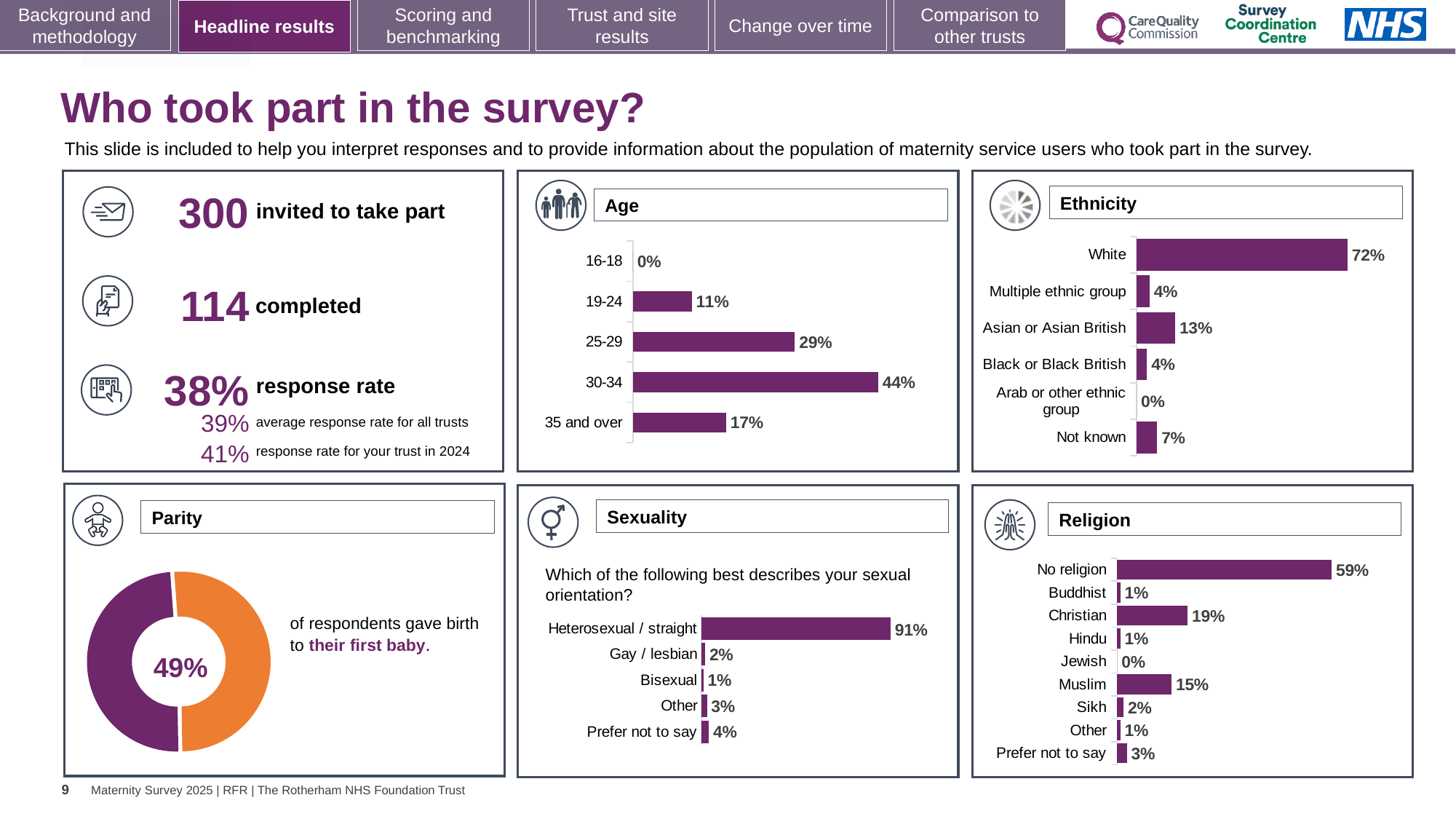
In the Religion chart, what percentage of respondents were Muslim? 15% In the Ethnicity chart, which is larger: Asian or Asian British or Not known? Asian or Asian British In the Age chart, what is the difference between the 25-29 and 19-24 percentages? 18% In the Ethnicity chart, what percentage of respondents were White? 72% In the Sexuality chart, what percentage of respondents answered Heterosexual / straight? 91% In the Sexuality chart, which category has the lowest percentage? Bisexual In the Ethnicity chart, how many ethnicity categories are shown? 6 What kind of chart is the Parity chart? Doughnut chart In the Age chart, what percentage of respondents were aged 30-34? 44% In the Age chart, which age group has the highest percentage? 30-34 In the Religion chart, what is the difference between No religion and Christian? 40% In the Parity chart, what percentage of respondents gave birth to their first baby? 49%